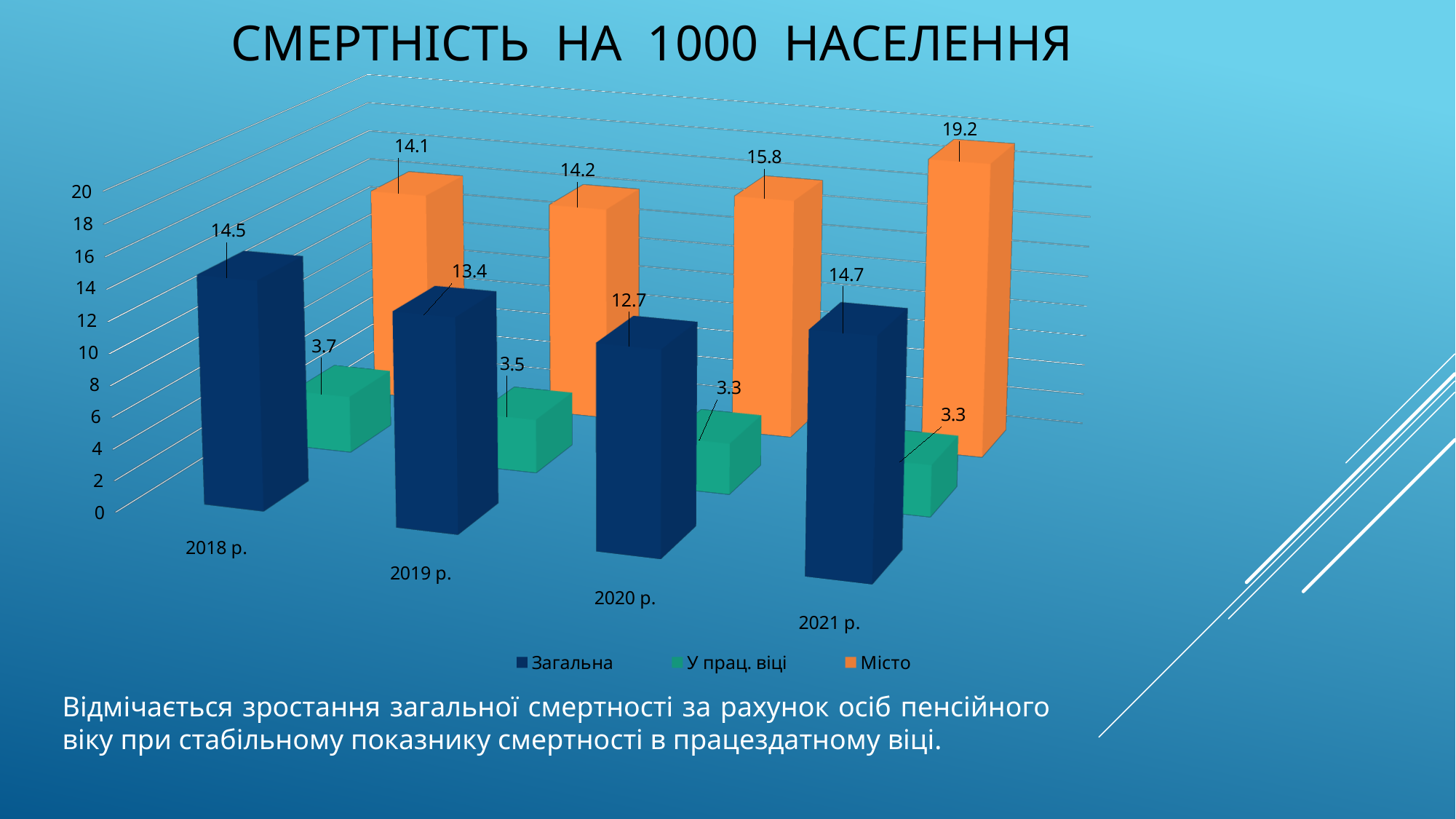
In which year is the Місто series highest? 2021 р. What is the value for У прац. віці in 2019 р.? 3.5 In which year is the Загальна series lowest? 2020 р. What is the value for Загальна in 2018 р.? 14.5 What is the difference between the Місто value in 2021 р. and the Місто value in 2020 р.? 3.4 What is the title of the chart? СМЕРТНІСТЬ НА 1000 НАСЕЛЕННЯ What kind of chart is shown on the slide? bar chart Does the Місто series rise or fall from 2018 р. to 2021 р.? rise Which is larger in 2019 р.: Загальна or Місто? Місто What is the value for Місто in 2021 р.? 19.2 How many series does the legend list? 3 How many years are shown on the x axis? 4